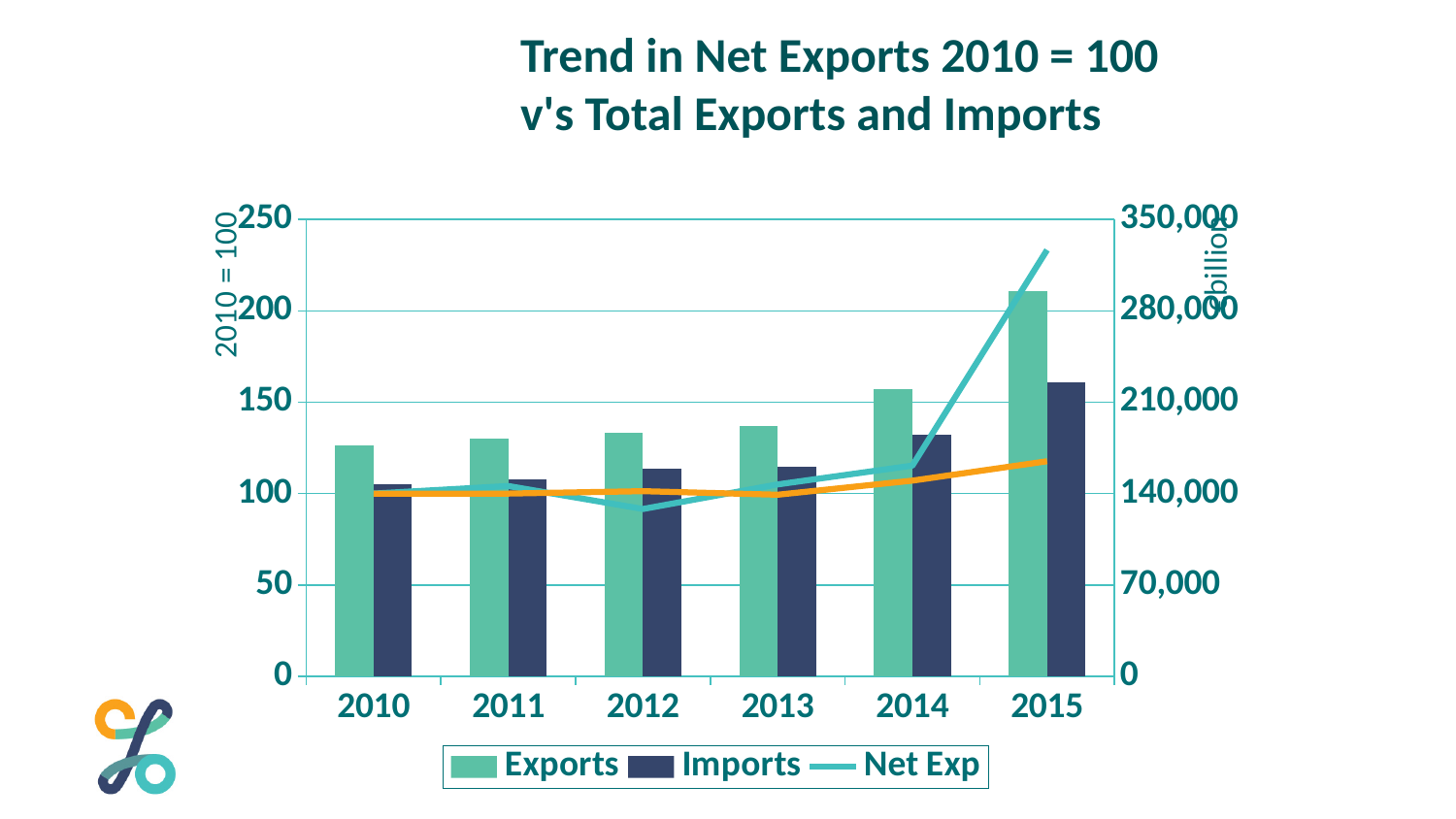
Is the Net Exp value for 2015 greater or less than 200 on the left-hand axis? greater In which year is the Exports bar highest? 2015 In 2015, which is larger, the Exports bar or the Imports bar? Exports How many series does the chart's legend list? 3 What are the series named in the chart's legend? Exports, Imports, Net Exp What kind of chart is shown on the slide? A combined bar and line chart Do the Exports bars generally rise or fall from 2010 to 2015? Rise What is the title of the chart? Trend in Net Exports 2010 = 100 v's Total Exports and Imports How many years are shown along the x axis of the chart? 6 In which year does the Net Exp line reach its highest point? 2015 In which year is the Imports bar lowest? 2010 In which year does the Net Exp line reach its lowest point? 2012